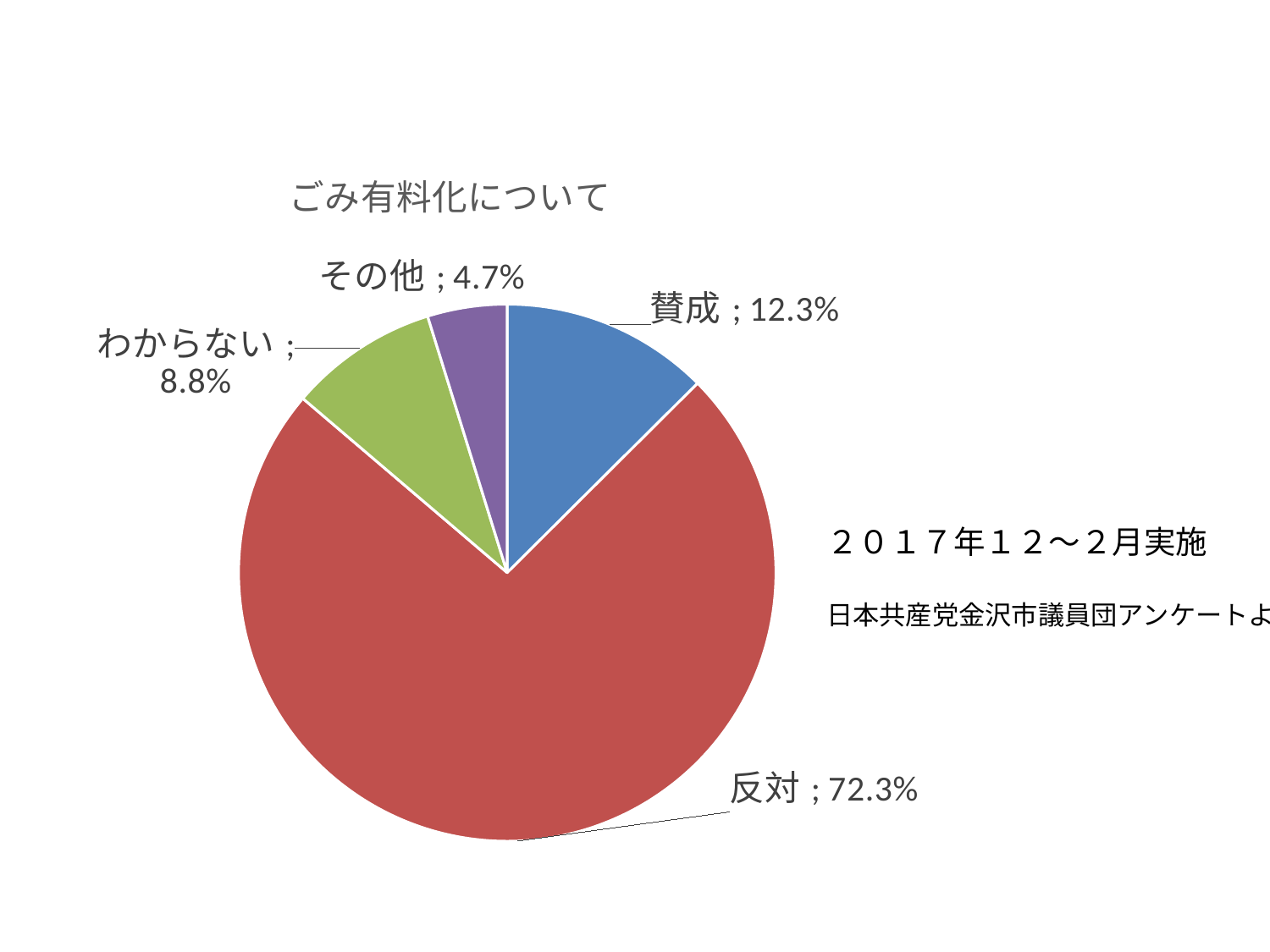
What colour is the slice for 反対? red Which is larger, the share for 賛成 or the share for わからない? 賛成 What percentage is shown for わからない? 8.8% Which category has the largest share of the pie? 反対 What percentage is shown for 反対? 72.3% What percentage is shown for その他? 4.7% What percentage is shown for 賛成? 12.3% What is the title of the chart? ごみ有料化について What is the difference in percentage points between 反対 and 賛成? 60 percentage points Which category has the smallest share of the pie? その他 How many slices does the pie chart have? 4 What type of chart is shown on the slide? pie chart